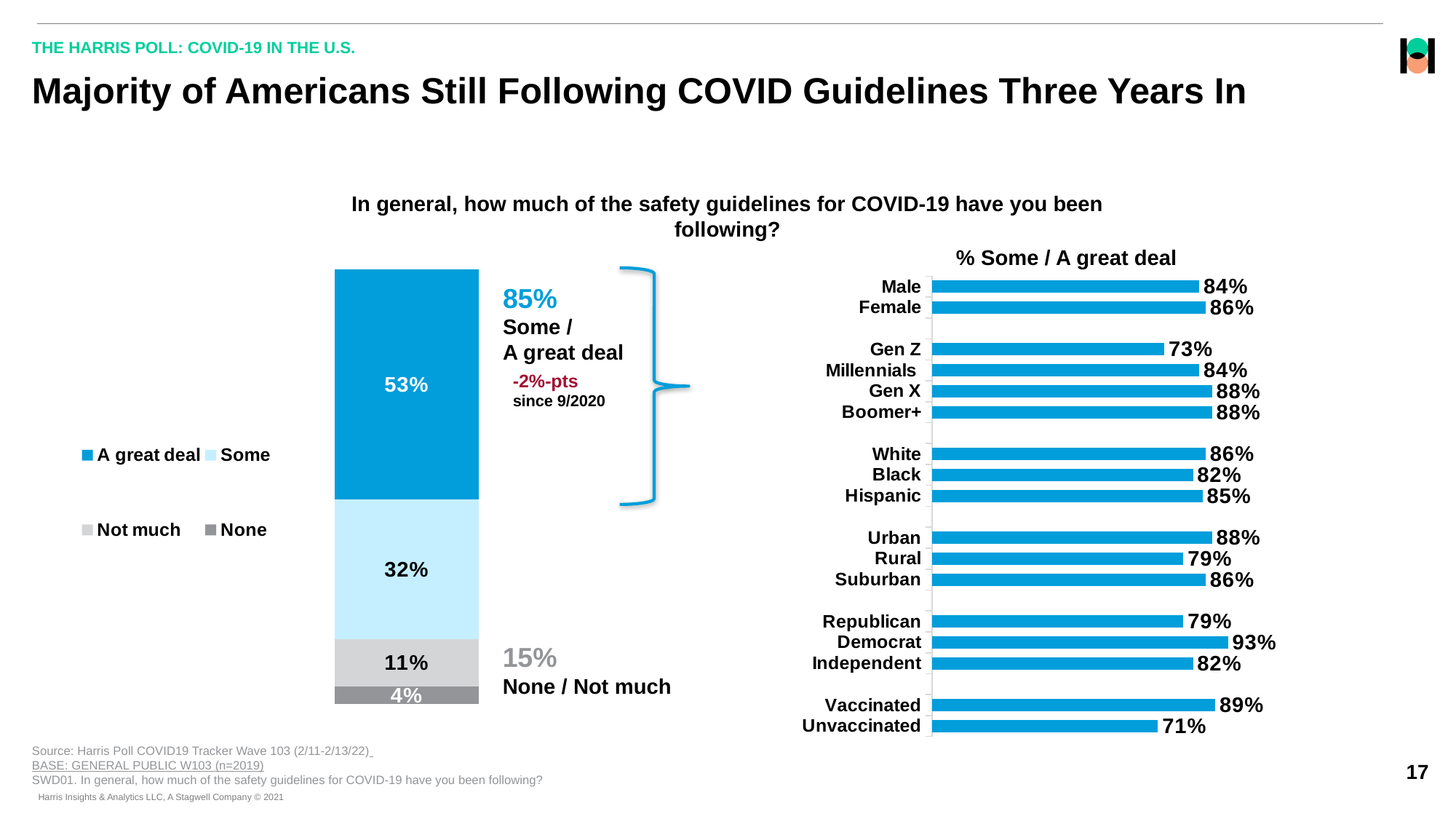
In the stacked bar chart on the left, how many segments make up the bar? 4 In the '% Some / A great deal' chart on the right, which is larger, the value for Gen Z or the value for Millennials? Millennials In the '% Some / A great deal' chart on the right, which group has the highest value? Democrat In the stacked bar chart on the left, what percentage of respondents answered 'None'? 4% In the '% Some / A great deal' chart on the right, which group has the lowest value? Unvaccinated In the stacked bar chart on the left, what percentage of respondents said they follow 'A great deal' of the COVID-19 safety guidelines? 53% What kind of chart is the '% Some / A great deal' chart on the right? Bar chart In the '% Some / A great deal' chart on the right, what is the difference between Vaccinated and Unvaccinated? 18% In the stacked bar chart on the left, what is the combined share for 'Some' and 'A great deal'? 85% In the '% Some / A great deal' chart on the right, what is the value for Unvaccinated? 71% In the stacked bar chart on the left, how many entries does the legend list? 4 In the '% Some / A great deal' chart on the right, what is the value for Democrat? 93%